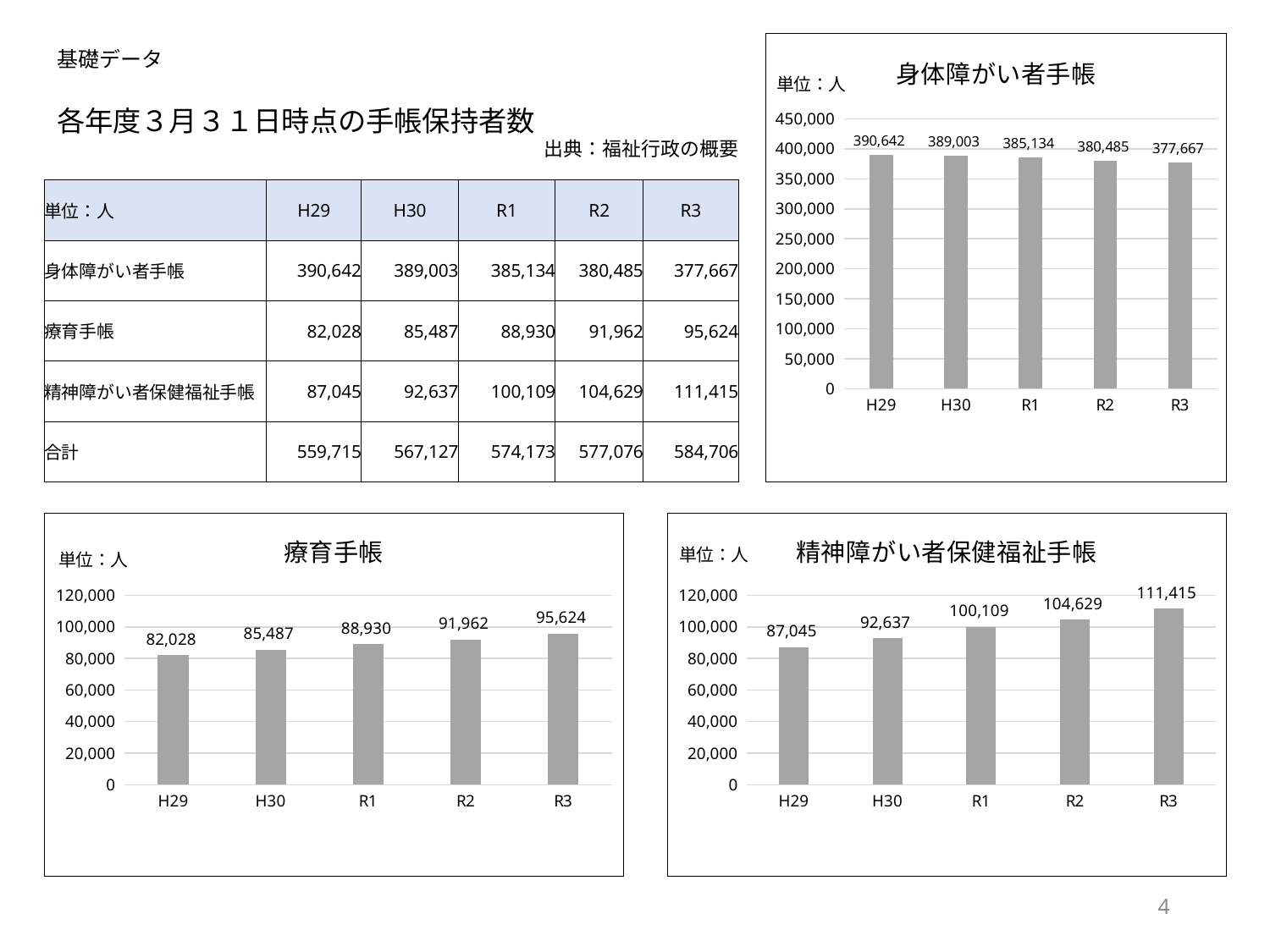
In the 身体障がい者手帳 chart, which year has the lowest value? R3 In the 療育手帳 chart, is the value for H29 greater or less than 100,000? less In the 精神障がい者保健福祉手帳 chart, what is the difference between the R3 and H29 values? 24,370 In the 療育手帳 chart, what is the value for R1? 88,930 In the 療育手帳 chart, which year has the highest value? R3 In the 精神障がい者保健福祉手帳 chart, which is larger, the value for H30 or the value for R1? R1 In the 身体障がい者手帳 chart, what is the value for H29? 390,642 In the 身体障がい者手帳 chart, do the values rise or fall from H29 to R3? fall In the 療育手帳 chart, how many bars are plotted? 5 In the 精神障がい者保健福祉手帳 chart, what is the value for R2? 104,629 In the 身体障がい者手帳 chart, what is the difference between the H29 and R3 values? 12,975 What kind of chart is the 精神障がい者保健福祉手帳 chart? bar chart